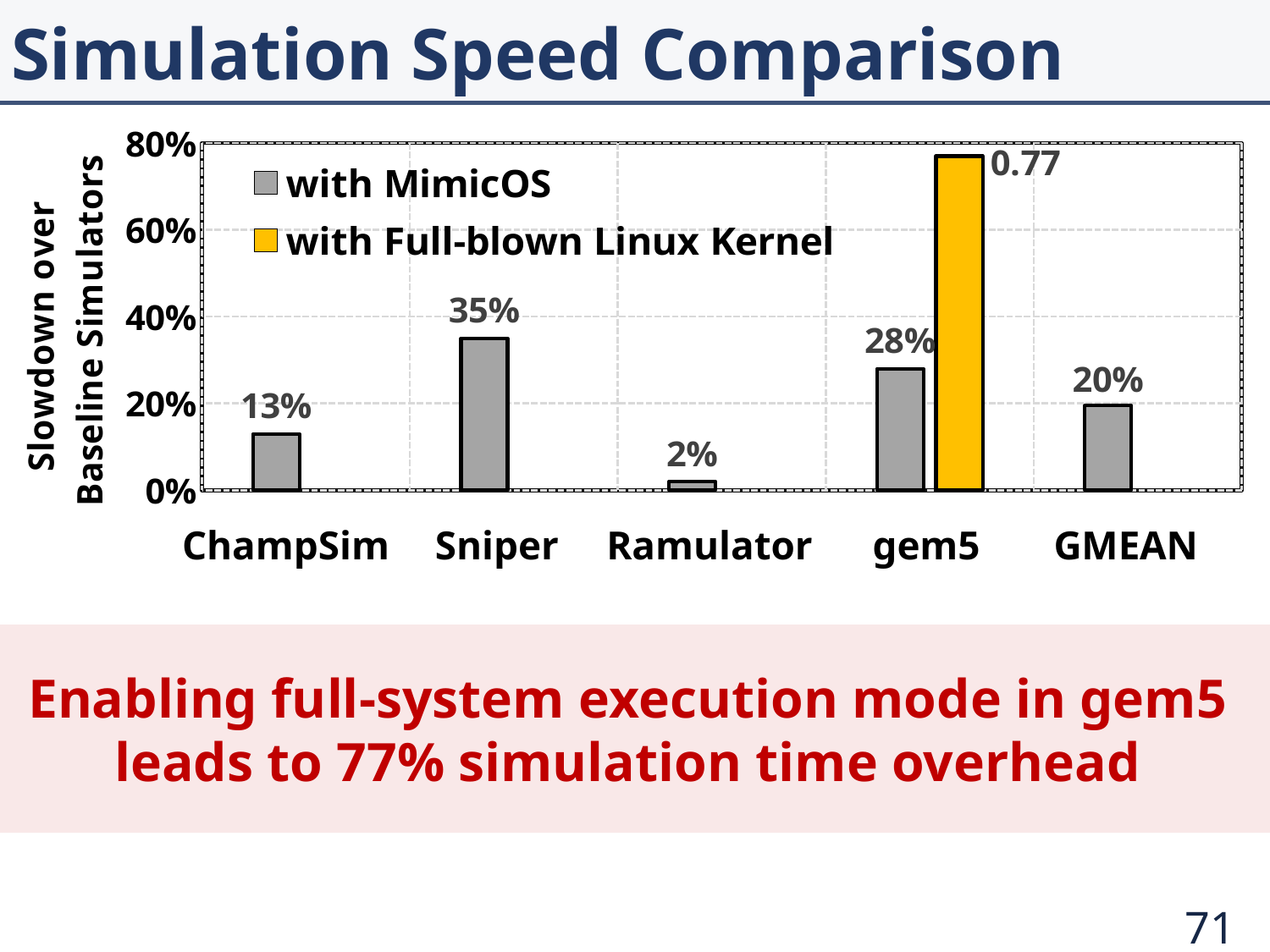
What is the slowdown for Sniper with MimicOS? 35% What is the GMEAN slowdown with MimicOS? 20% Which is larger: the gem5 slowdown with MimicOS or the GMEAN slowdown with MimicOS? gem5 What value is labelled on the gem5 bar for 'with Full-blown Linux Kernel'? 0.77 Is the gem5 slowdown with the Full-blown Linux Kernel greater or less than 60%? greater How many series does the legend list? 2 Which simulator has the lowest slowdown with MimicOS? Ramulator What is the difference between the Sniper and ChampSim slowdowns with MimicOS? 22% What is the slowdown for Ramulator with MimicOS? 2% How many categories are shown on the x axis? 5 What is the slowdown for ChampSim with MimicOS? 13% Which simulator has the highest slowdown with MimicOS? Sniper